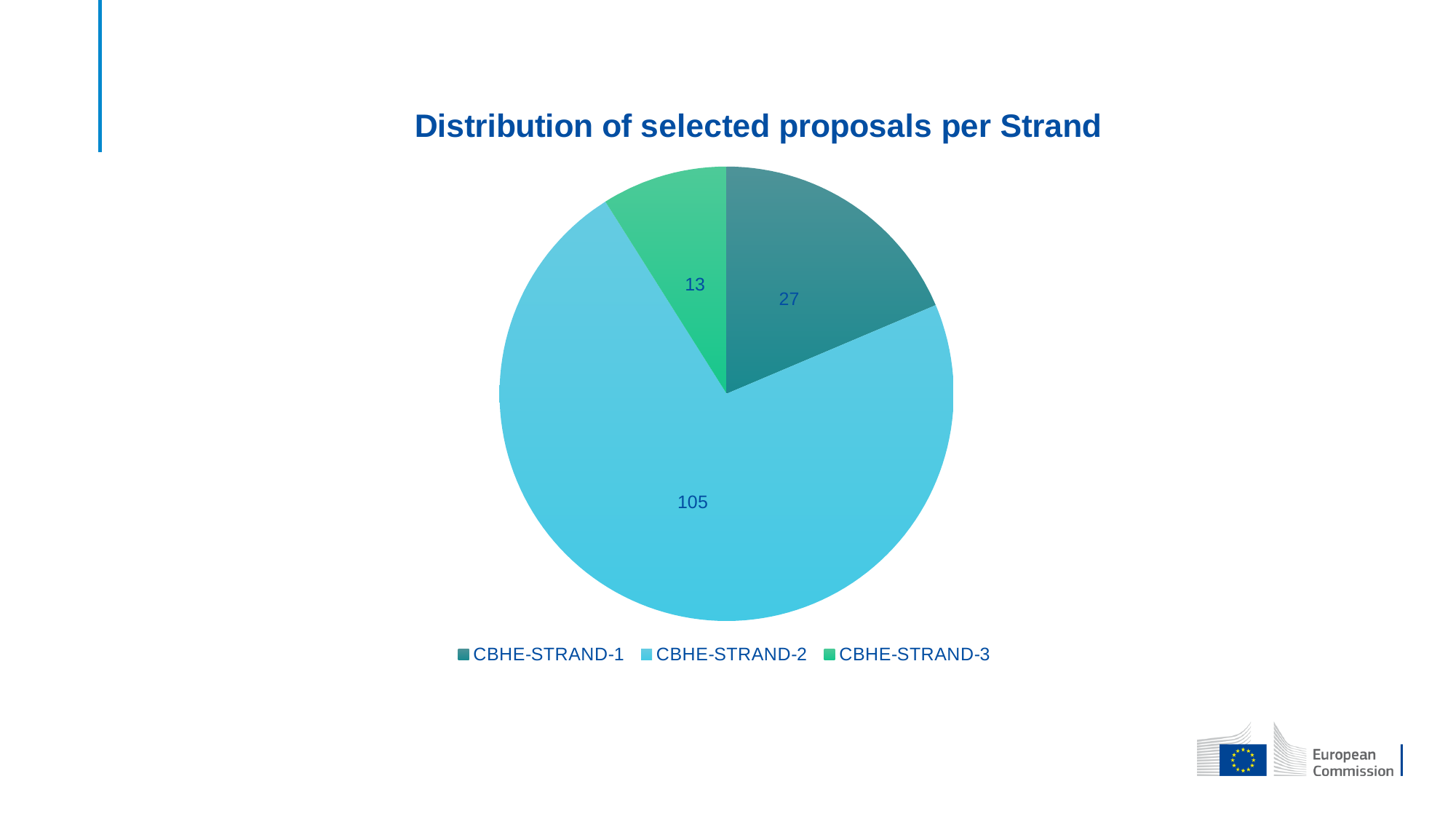
What is the total number of selected proposals across all three strands? 145 What is the difference between the number of selected proposals for CBHE-STRAND-2 and CBHE-STRAND-1? 78 Which strand has the smallest number of selected proposals? CBHE-STRAND-3 How many selected proposals are shown for CBHE-STRAND-2? 105 How many selected proposals are shown for CBHE-STRAND-1? 27 What type of chart is shown on the slide? pie chart Which strand has the largest number of selected proposals? CBHE-STRAND-2 What is the difference between the number of selected proposals for CBHE-STRAND-1 and CBHE-STRAND-3? 14 Which has more selected proposals, CBHE-STRAND-1 or CBHE-STRAND-3? CBHE-STRAND-1 What is the title of the chart? Distribution of selected proposals per Strand How many strands are shown in the pie chart? 3 How many selected proposals are shown for CBHE-STRAND-3? 13